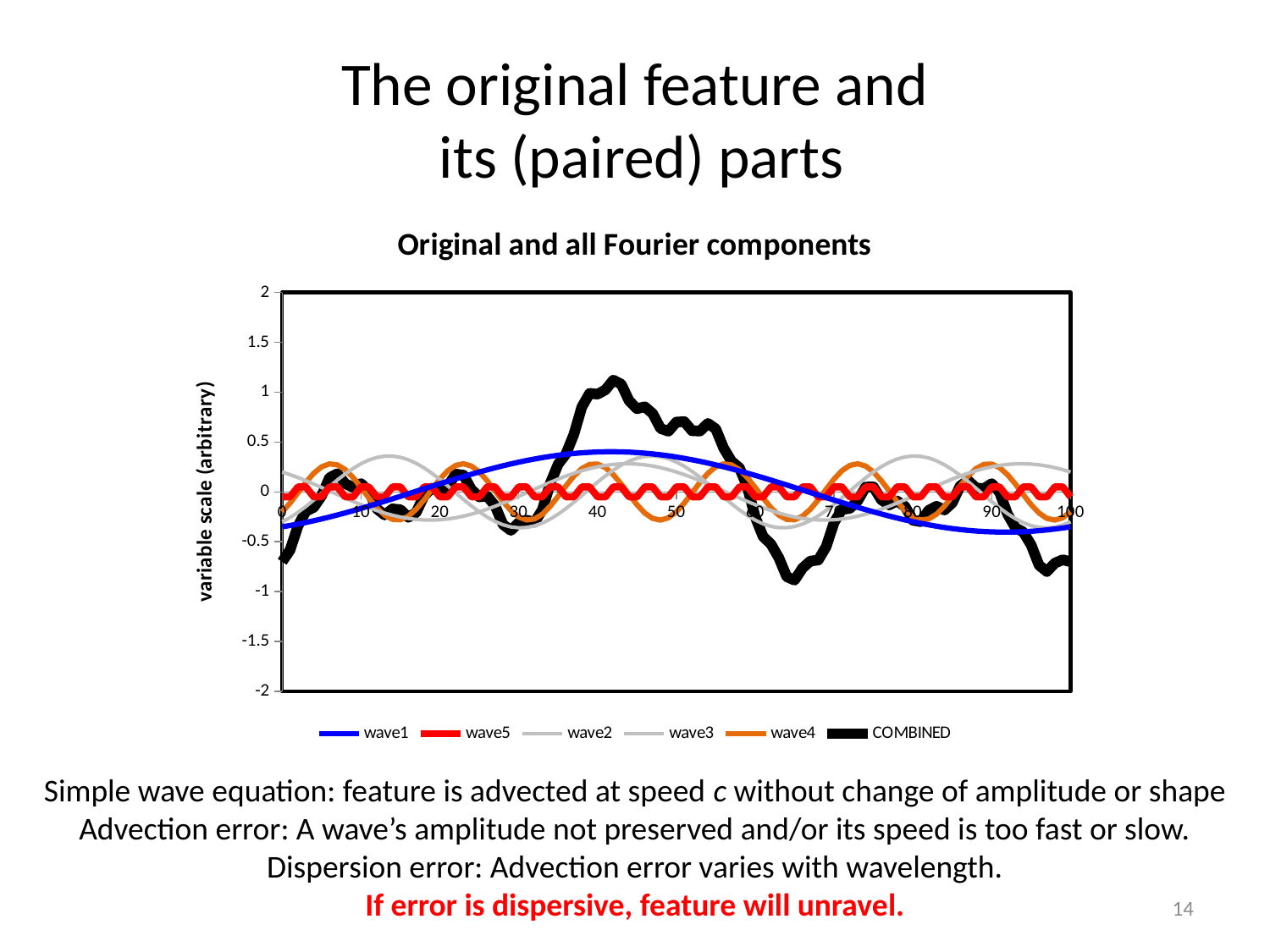
Which series reaches the lowest value on the chart? COMBINED Which series reaches the highest value on the chart? COMBINED What is the maximum value shown on the vertical axis? 2 Is the peak value of the wave1 series greater or less than 0? greater What is the label on the vertical axis of the chart? variable scale (arbitrary) How many series does the chart legend list? 6 Is the lowest value of the COMBINED series greater or less than -0.5? less What is the title of the chart? Original and all Fourier components Is the peak value of the COMBINED series greater or less than 0.5? greater Which series has the larger peak value, COMBINED or wave1? COMBINED What kind of chart is shown on the slide? line chart